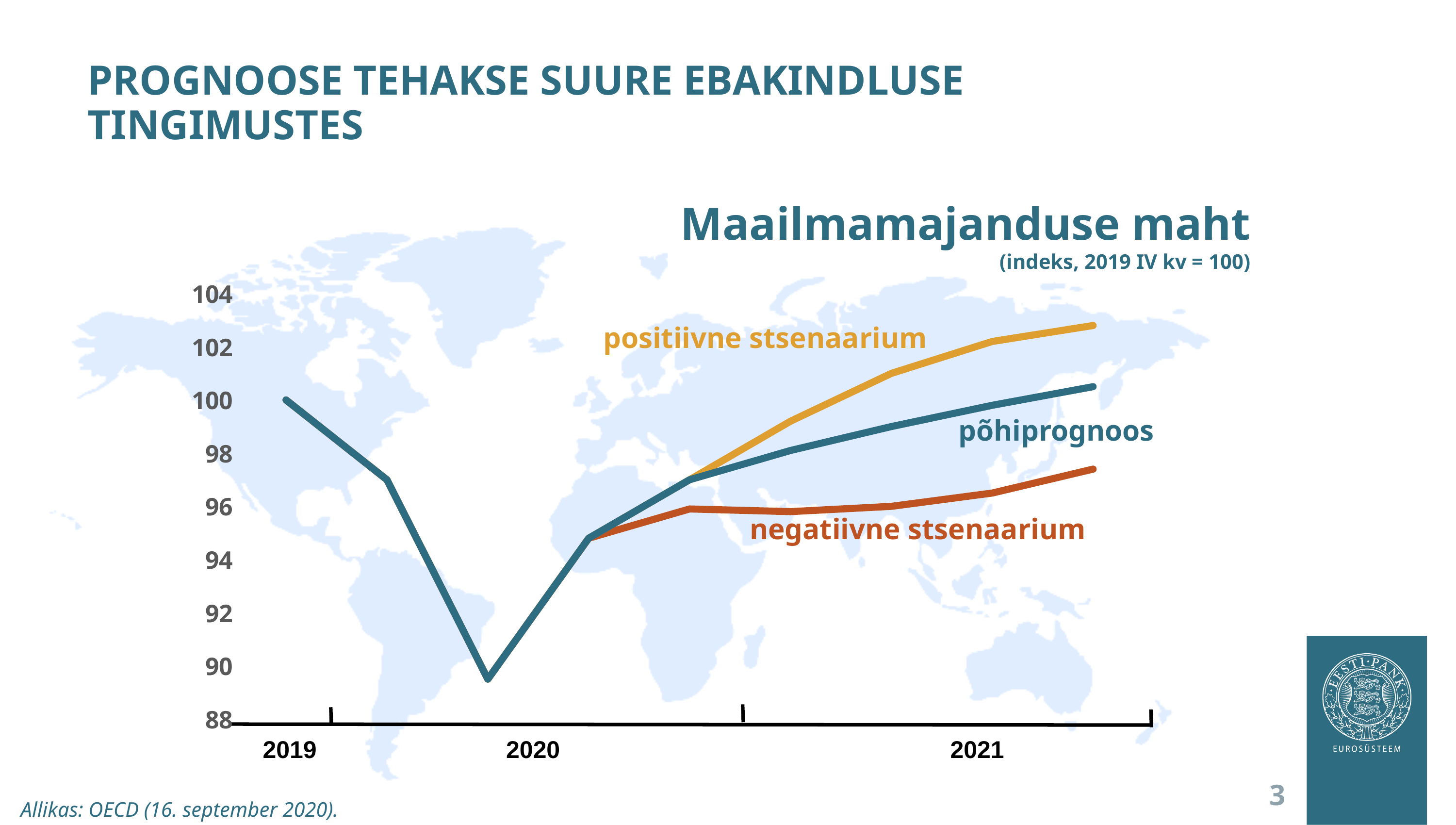
What is the title of the chart? Maailmamajanduse maht At the end of 2021, is the value of the põhiprognoos greater or less than 100? greater Which scenario line ends highest at the end of 2021? positiivne stsenaarium What colour is the line for the negatiivne stsenaarium? red How many series (lines) are labelled on the chart? 3 At the end of 2021, is the value of the positiivne stsenaarium greater or less than 102? greater Which scenario line ends lowest at the end of 2021? negatiivne stsenaarium Does the index rise or fall from the start of the series in 2019 to its lowest point in 2020? fall What kind of chart is shown on the slide? line chart Which is larger at the end of 2021: the positiivne stsenaarium or the negatiivne stsenaarium? positiivne stsenaarium What is the index value at the start of the series, in 2019 IV kv, according to the chart subtitle? 100 At the end of 2021, is the value of the negatiivne stsenaarium greater or less than 98? less